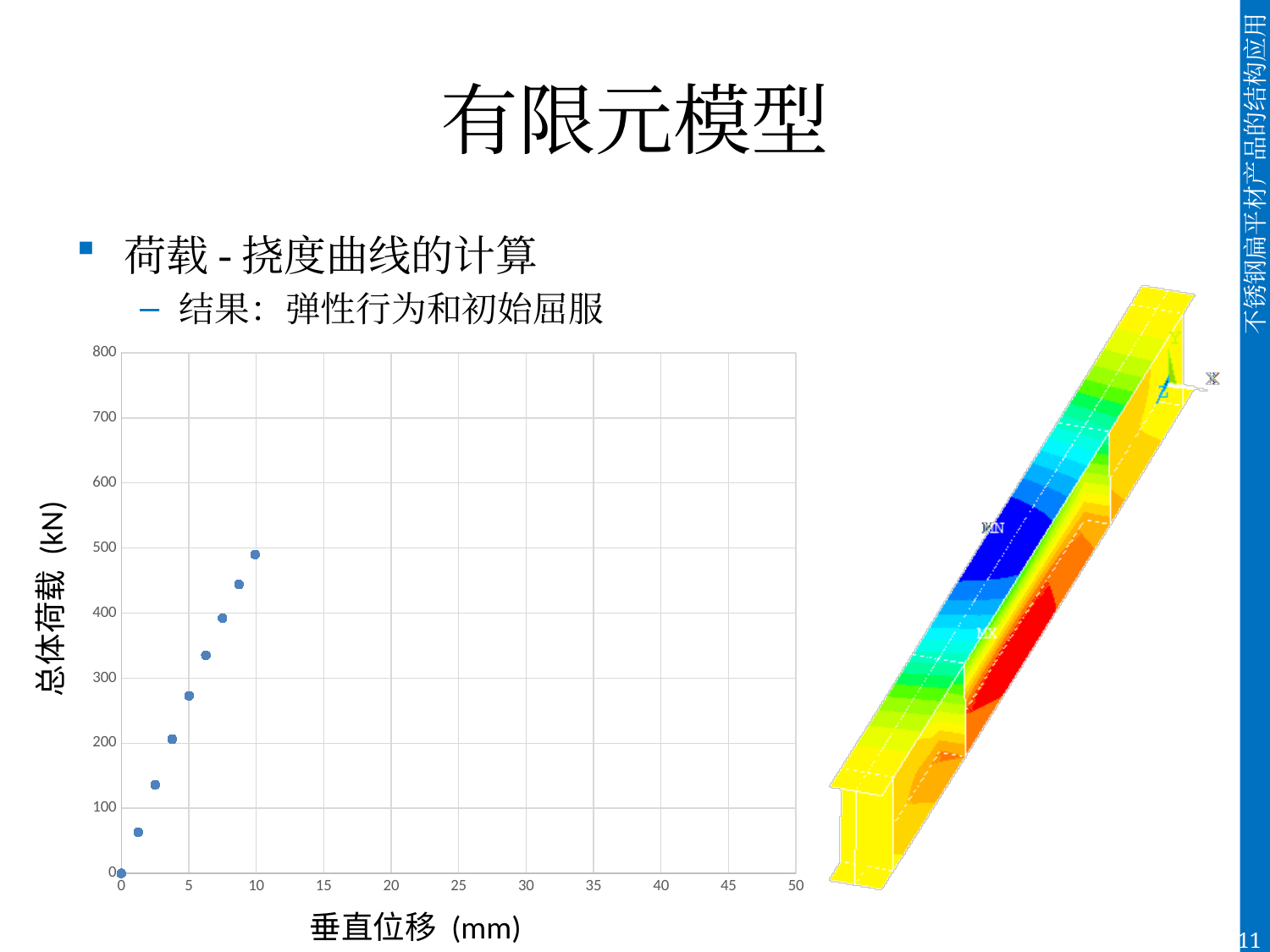
What is the maximum value shown on the x axis? 50 Is the highest plotted load value greater or less than 400 kN? greater What kind of chart is shown on the slide? scatter chart What is the title of the chart's y axis? 总体荷载 (kN) Is the highest plotted load value greater or less than 600 kN? less What is the title of the chart's x axis? 垂直位移 (mm) Is the load at a vertical displacement of about 5 mm greater or less than 300 kN? less Do the plotted values rise or fall as vertical displacement (垂直位移) increases? rise How many data points are plotted on the chart? 9